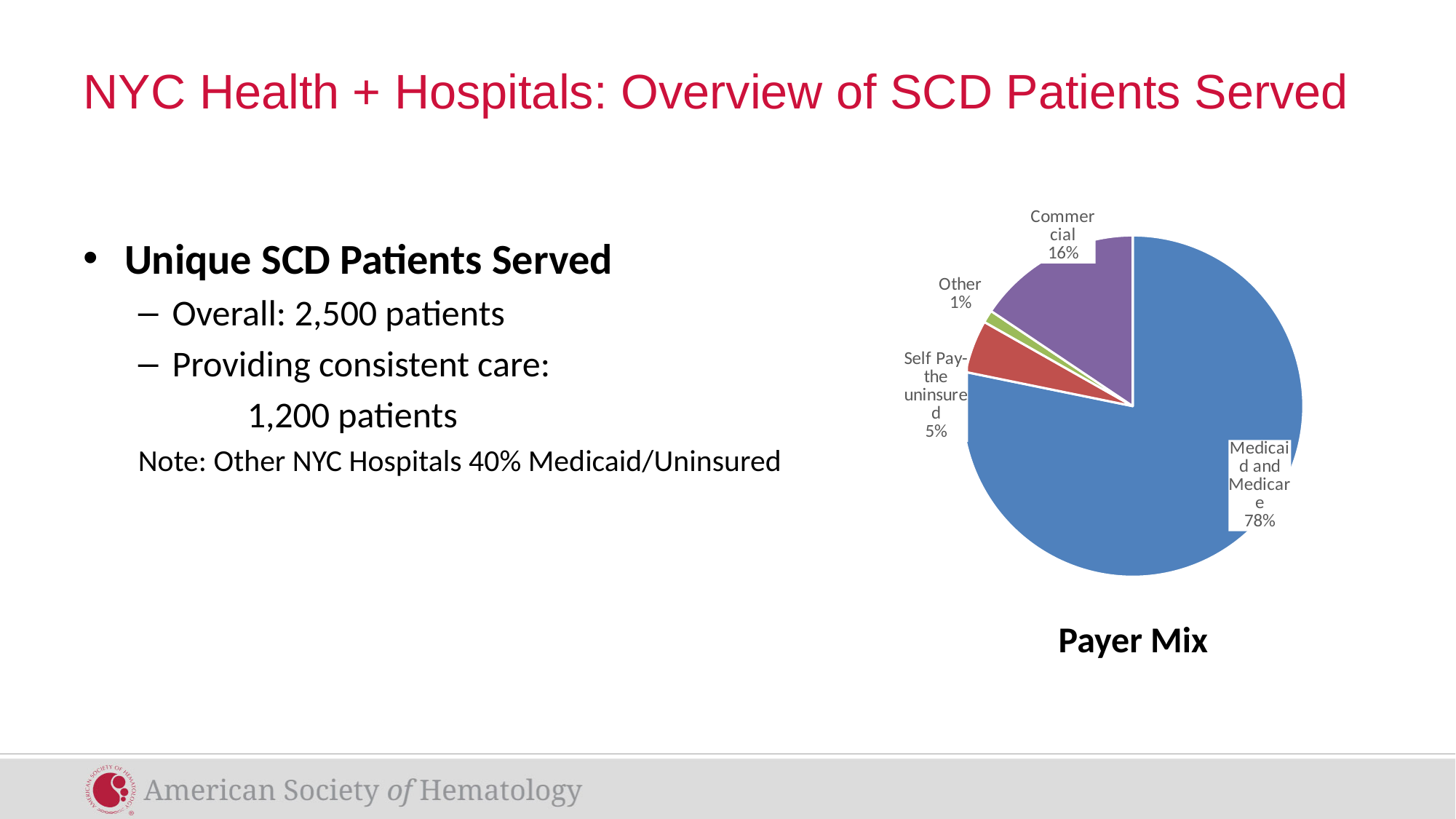
In the Payer Mix pie, how many percentage points larger is Medicaid and Medicare than Commercial? 62 Which payer category has the largest slice in the Payer Mix pie? Medicaid and Medicare What kind of chart is the Payer Mix chart? pie chart What share of the Payer Mix pie is Self Pay-the uninsured? 5% How many slices does the Payer Mix pie chart have? 4 In the Payer Mix pie, which is larger: Commercial or Self Pay-the uninsured? Commercial What colour is the Medicaid and Medicare slice in the Payer Mix pie? blue Which payer category has the smallest slice in the Payer Mix pie? Other What is the title of the pie chart on the slide? Payer Mix What share of the Payer Mix pie is Medicaid and Medicare? 78% What share of the Payer Mix pie is Other? 1%